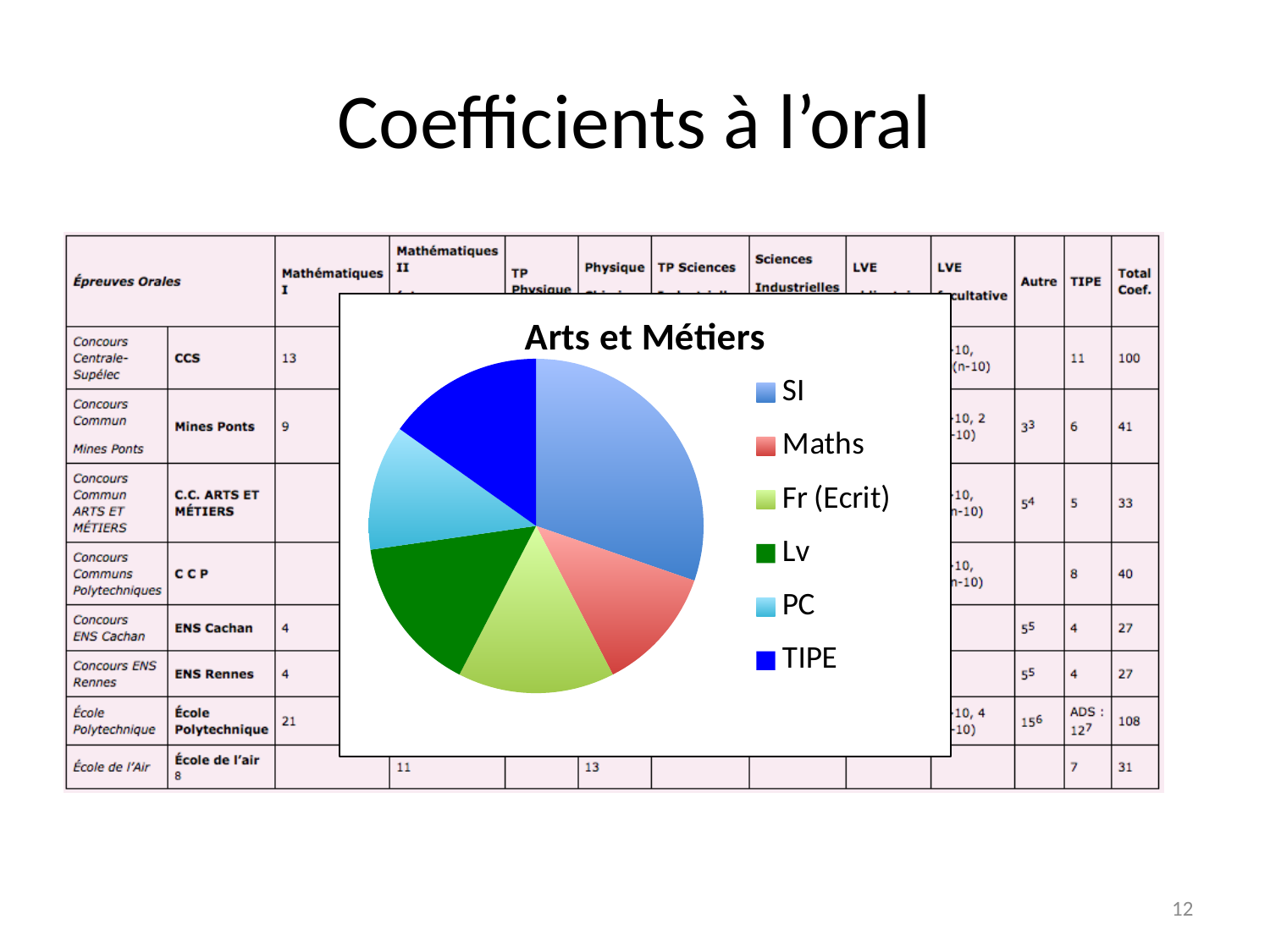
Which slice is larger in the pie chart, SI or Lv? SI Which legend entry is shown in dark blue in the pie chart? TIPE How many slices does the pie chart have? 6 Which slice is larger in the pie chart, SI or TIPE? SI Which category has the largest slice in the pie chart? SI Which slice is larger in the pie chart, SI or Maths? SI How many entries does the legend of the pie chart list? 6 What is the title of the pie chart? Arts et Métiers What kind of chart is shown on the slide? pie chart